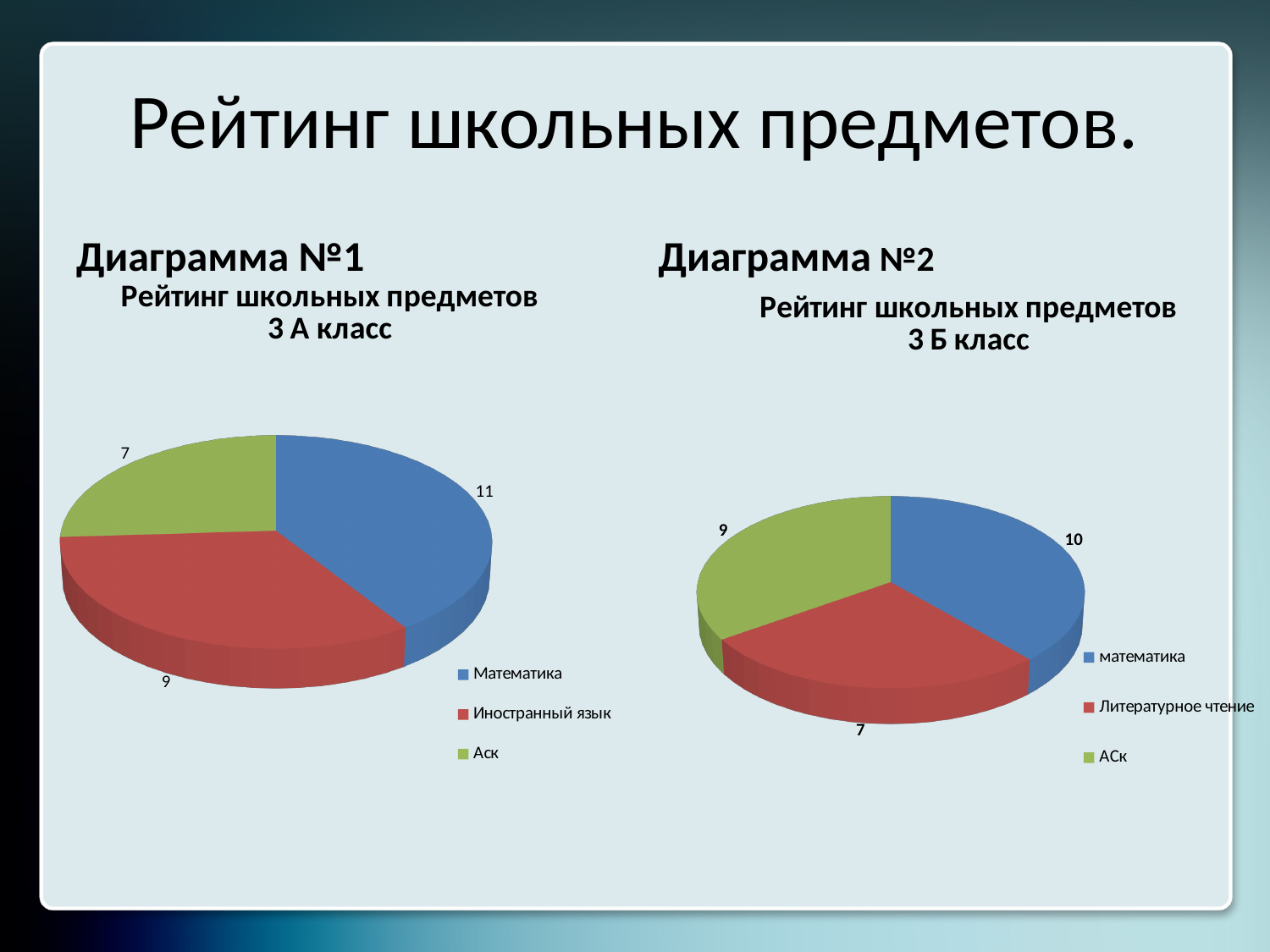
In the chart for 3 А класс (Диаграмма №1), which colour represents Аск? Green In the chart for 3 Б класс (Диаграмма №2), what is the value for АСк? 9 How many slices does the chart for 3 Б класс (Диаграмма №2) have? 3 In the chart for 3 А класс (Диаграмма №1), which subject has the largest slice? Математика In the chart for 3 А класс (Диаграмма №1), what is the value for Иностранный язык? 9 In the chart for 3 Б класс (Диаграмма №2), which is larger: математика or АСк? математика What type of chart is Диаграмма №1 (3 А класс)? Pie chart In the chart for 3 А класс (Диаграмма №1), what is the difference between the values for Математика and Аск? 4 In the chart for 3 Б класс (Диаграмма №2), which subject has the smallest slice? Литературное чтение In the chart for 3 Б класс (Диаграмма №2), what is the value for Литературное чтение? 7 In the chart for 3 А класс (Диаграмма №1), what is the total of all three values? 27 In the chart for 3 А класс (Диаграмма №1), what is the value for Математика? 11